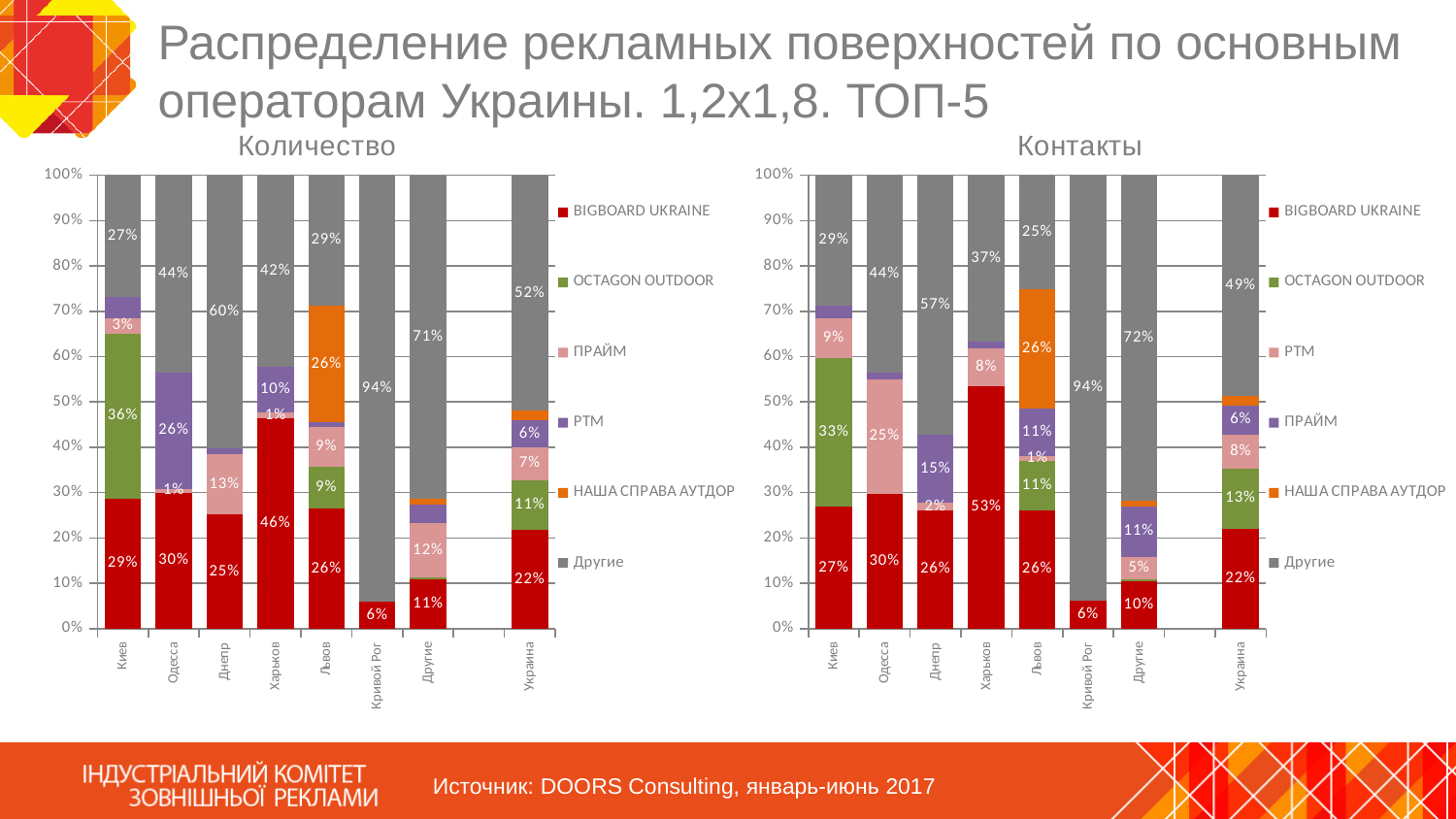
In the "Количество" chart, what is the BIGBOARD UKRAINE share for Харьков? 46% In the "Количество" chart, what is the difference between the "Другие" share for Днепр and for Одесса? 16% In the "Количество" chart, what is the "Другие" share for Кривой Рог? 94% In the "Контакты" chart, which category has the lowest BIGBOARD UKRAINE share? Кривой Рог What kind of chart is the "Количество" chart on the left? Stacked bar chart In the "Контакты" chart, what is the BIGBOARD UKRAINE share for Харьков? 53% How many categories are shown on the x axis of the "Контакты" chart? 8 In the "Контакты" chart, what is the НАША СПРАВА АУТДОР share for Львов? 26% In the "Количество" chart, which city has the highest BIGBOARD UKRAINE share? Харьков In the "Количество" chart, what is the OCTAGON OUTDOOR share for Киев? 36% How many series does the legend of the "Количество" chart list? 6 In the "Контакты" chart, what is the "Другие" share for Украина? 49%